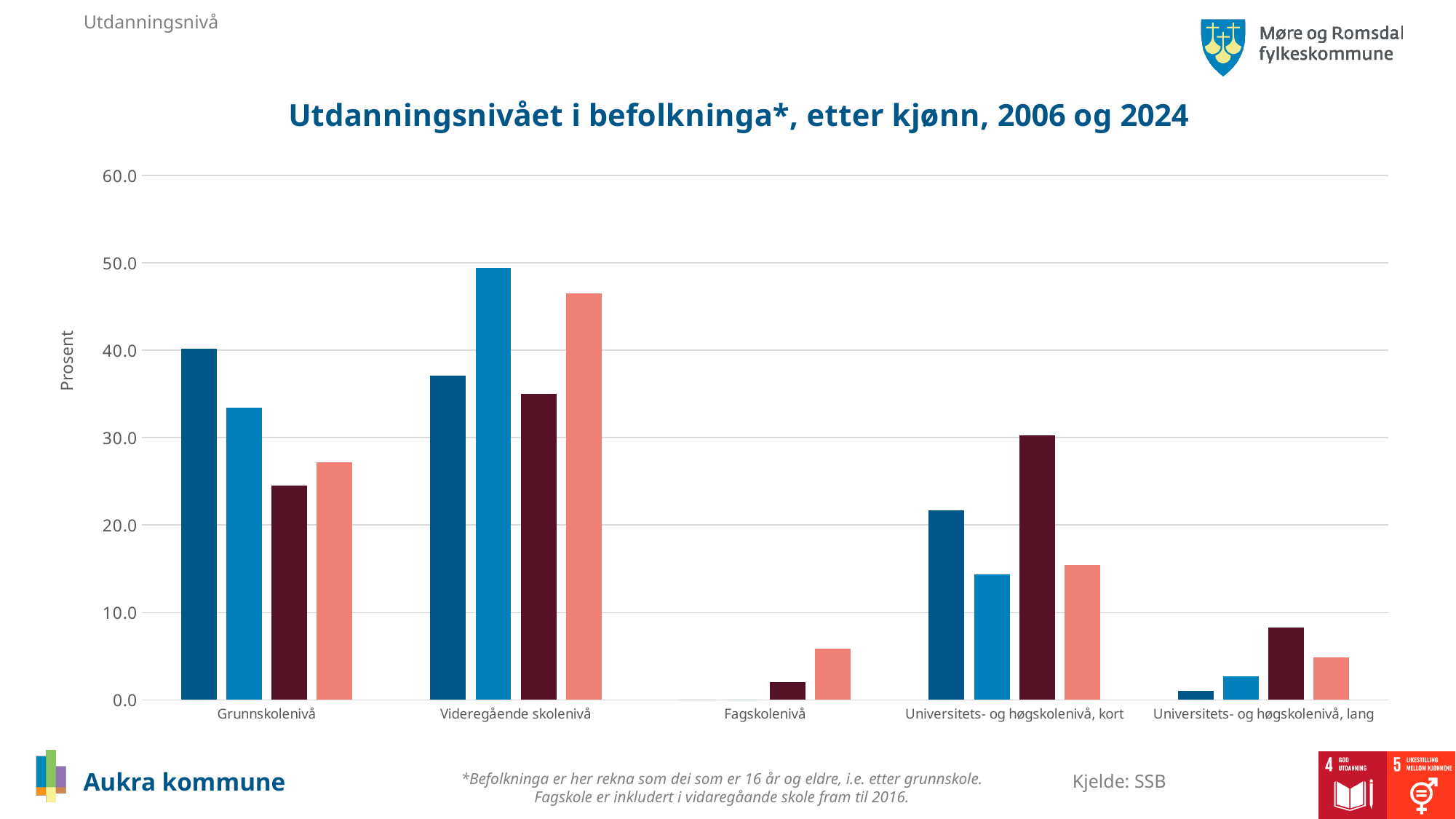
Is the value of the light blue bar for Grunnskolenivå greater or less than 30? greater Which category contains the shortest bar in the chart? Universitets- og høgskolenivå, lang How many bars are plotted for the Fagskolenivå category? 2 Which category contains the tallest bar in the chart? Videregående skolenivå What is the title of the chart? Utdanningsnivået i befolkninga*, etter kjønn, 2006 og 2024 What kind of chart is shown on the slide? bar chart Which is larger: the dark blue bar for Grunnskolenivå or the dark blue bar for Videregående skolenivå? Grunnskolenivå What is the label of the vertical axis? Prosent Is the value of the dark blue bar for Universitets- og høgskolenivå, kort greater or less than 20? greater Is the value of the salmon (light red) bar for Fagskolenivå greater or less than 10? less How many categories are shown on the x axis of the chart? 5